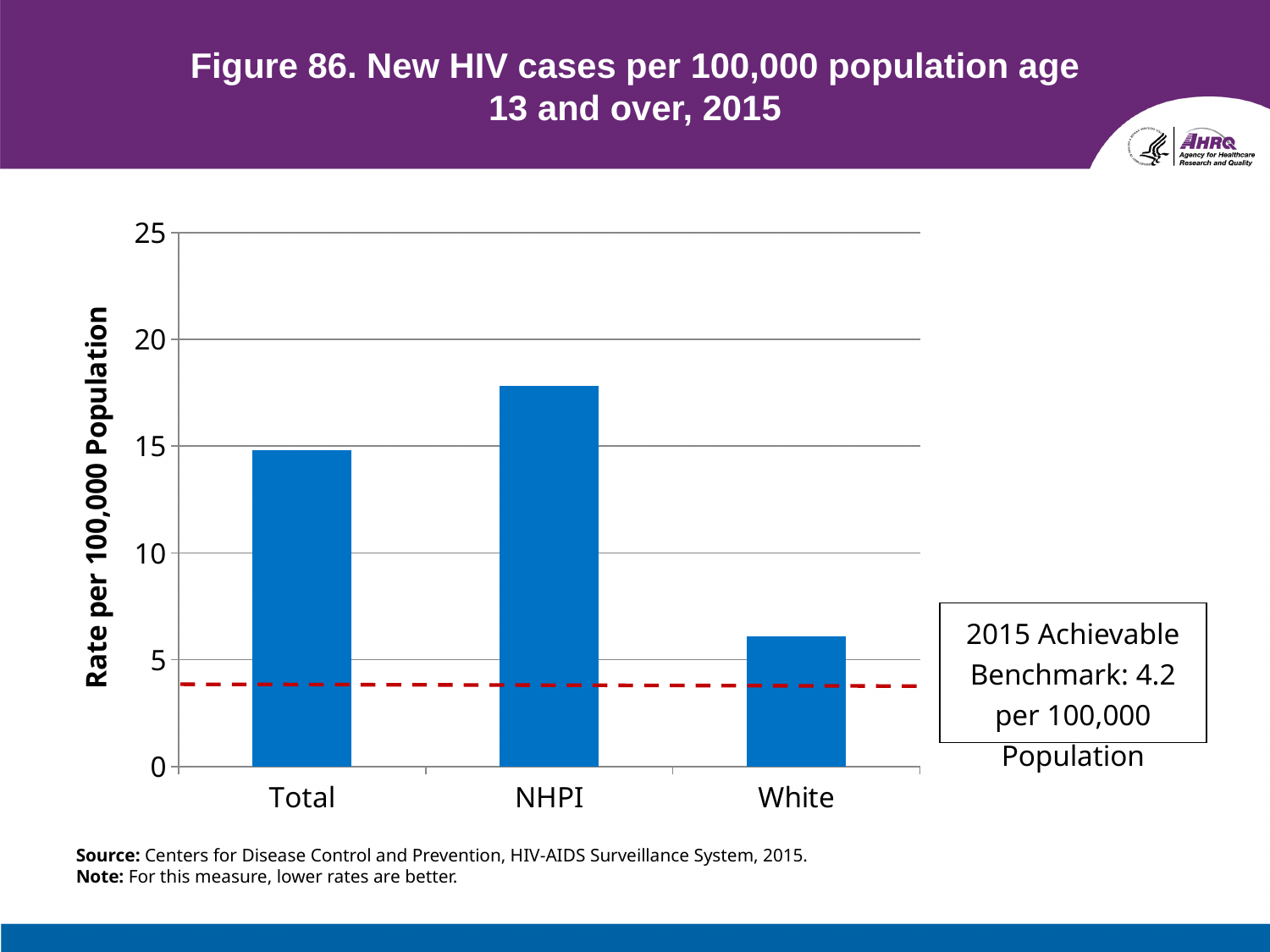
Which category has the lowest rate? White Which category has the highest rate? NHPI What kind of chart is shown on the slide? bar chart What is the label of the y axis? Rate per 100,000 Population Is the rate for NHPI greater or less than 20? less What is the title of the chart? Figure 86. New HIV cases per 100,000 population age 13 and over, 2015 How many categories are shown on the x axis? 3 Which is larger, the rate for Total or the rate for White? Total What is the value of the 2015 Achievable Benchmark shown by the dashed line? 4.2 per 100,000 Population Is the rate for NHPI greater or less than 15? greater Is the rate for Total greater or less than 10? greater